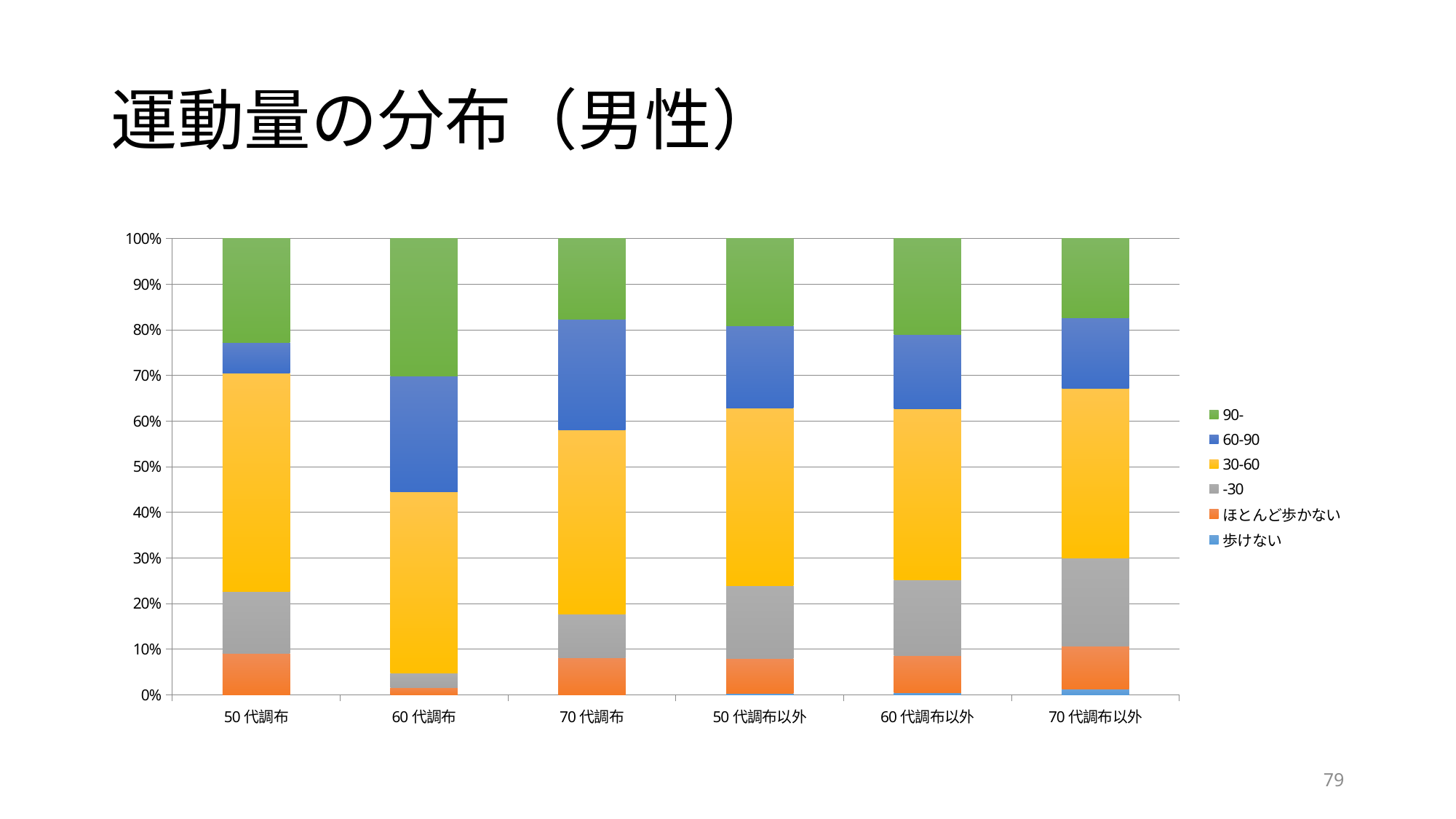
Which category has the smallest ほとんど歩かない segment? 60代調布 What kind of chart is shown on the slide? Stacked bar chart Which category has the largest 90- segment? 60代調布 Is the 60-90 share for 50代調布 greater or less than 10%? less Is the 30-60 share for 50代調布 greater or less than 40%? greater How many series does the legend list? 6 How many categories are shown along the x axis? 6 Which category has the largest 30-60 segment? 50代調布 Which is larger, the 60-90 segment for 60代調布 or for 50代調布? 60代調布 What is the title of the chart slide? 運動量の分布（男性） Which category has the smallest -30 segment? 60代調布 Is the 90- share for 60代調布 greater or less than 20%? greater